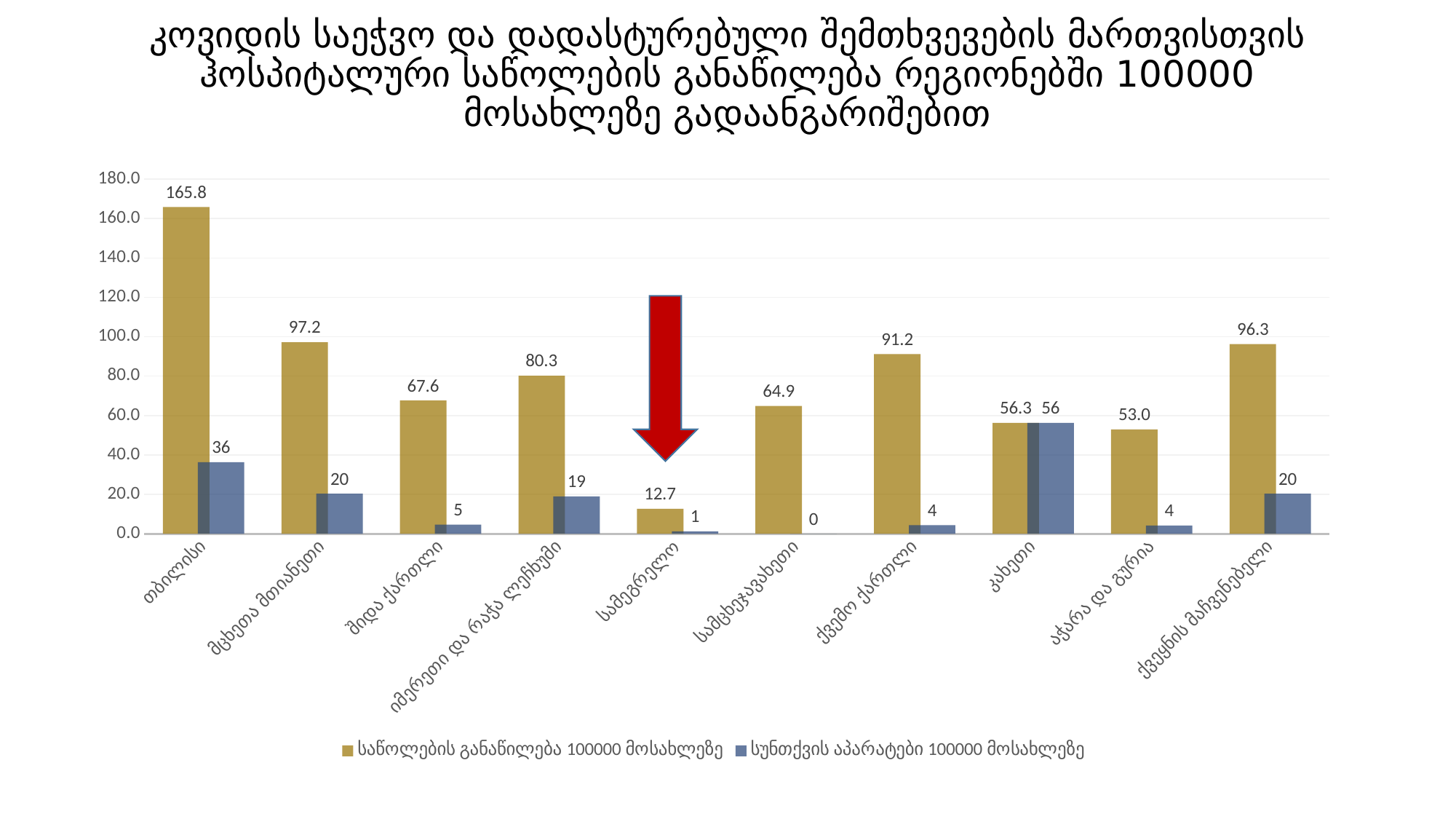
How many series does the legend list? 2 Which category has the lowest value for სუნთქვის აპარატები 100000 მოსახლეზე? სამცხეჯავახეთი What kind of chart is shown on the slide? bar chart How many categories are shown on the x axis? 10 What is the value of საწოლების განაწილება 100000 მოსახლეზე for სამეგრელო? 12.7 Which is larger for საწოლების განაწილება 100000 მოსახლეზე: იმერეთი და რაჭა ლეჩხუმი or შიდა ქართლი? იმერეთი და რაჭა ლეჩხუმი What is the value of სუნთქვის აპარატები 100000 მოსახლეზე for კახეთი? 56 What is the difference between the საწოლების განაწილება 100000 მოსახლეზე values for მცხეთა მთიანეთი and ქვემო ქართლი? 6.0 What is the value of საწოლების განაწილება 100000 მოსახლეზე for თბილისი? 165.8 What colour are the bars for სუნთქვის აპარატები 100000 მოსახლეზე? blue Which category has the highest value for საწოლების განაწილება 100000 მოსახლეზე? თბილისი Is the value of საწოლების განაწილება 100000 მოსახლეზე for ქვეყნის მაჩვენებელი greater or less than 80.0? greater